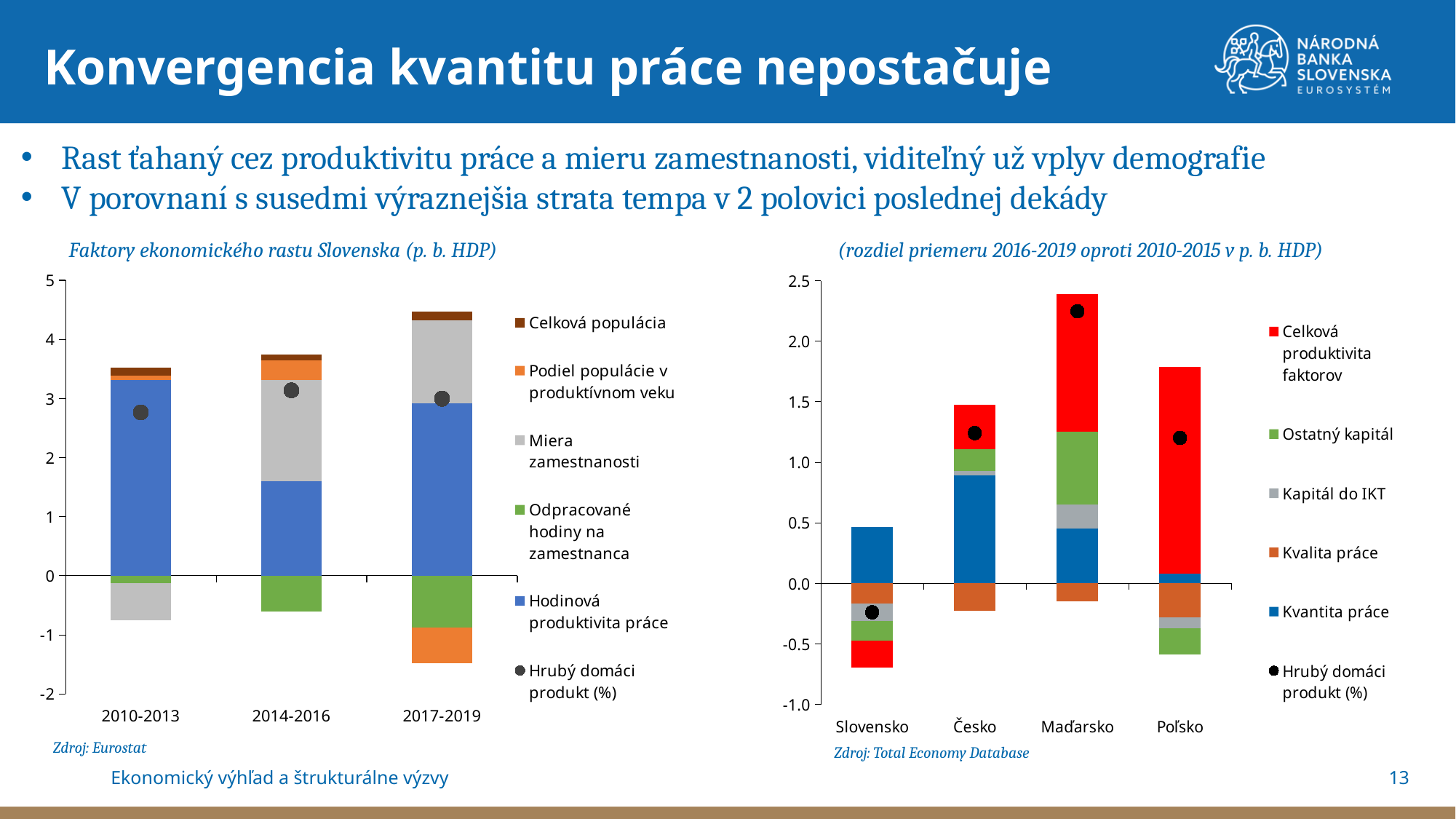
How many time periods are shown on the x axis of the left chart, 'Faktory ekonomického rastu Slovenska'? 3 What kind of chart is the left chart, 'Faktory ekonomického rastu Slovenska (p. b. HDP)'? Stacked bar chart In the right chart, which country has the larger Kvantita práce segment, Slovensko or Česko? Česko In the left chart, is the Hrubý domáci produkt (%) dot for 2010-2013 greater or less than 3? less In the left chart, which period has the larger Hodinová produktivita práce segment, 2010-2013 or 2014-2016? 2010-2013 In the right chart, which country has the lowest Hrubý domáci produkt (%) dot? Slovensko How many entries does the legend of the right chart list? 6 How many countries are shown on the x axis of the right chart? 4 In the right chart, which country has the highest Hrubý domáci produkt (%) dot? Maďarsko In the right chart, is the Hrubý domáci produkt (%) dot for Slovensko greater or less than 0.0? less In the right chart, is the Hrubý domáci produkt (%) dot for Maďarsko greater or less than 2.0? greater